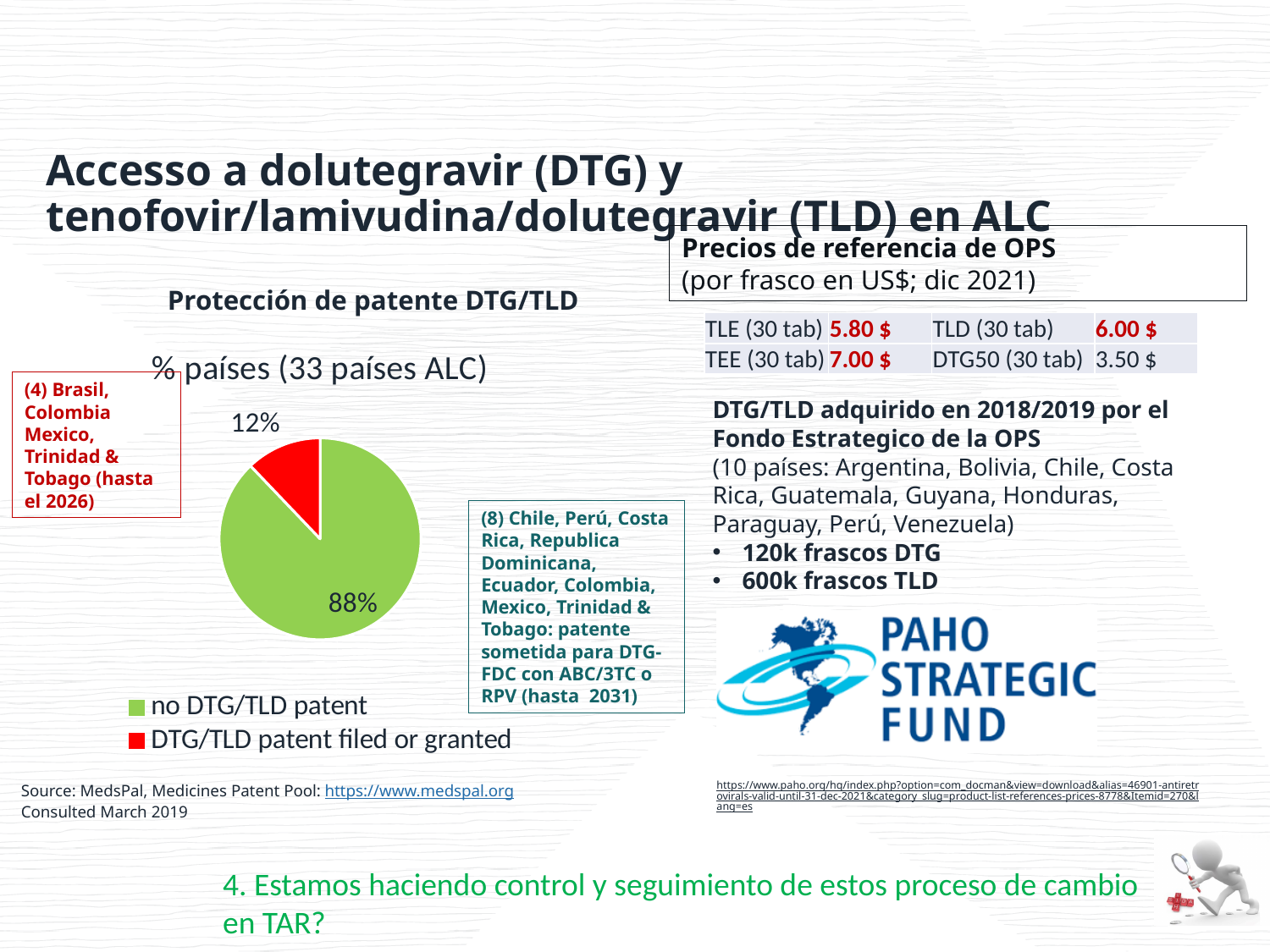
What kind of chart is shown on the slide? pie chart Which is larger: the share of countries with no DTG/TLD patent or the share with a DTG/TLD patent filed or granted? no DTG/TLD patent Which category has the largest share of the pie? no DTG/TLD patent What is the difference in percentage points between the 'no DTG/TLD patent' slice and the 'DTG/TLD patent filed or granted' slice? 76 How many slices does the pie chart have? 2 What percentage of countries have a DTG/TLD patent filed or granted? 12% What is the title of the pie chart? % países (33 países ALC) Which category has the smallest share of the pie? DTG/TLD patent filed or granted How many entries does the legend list? 2 What colour represents 'DTG/TLD patent filed or granted' in the pie chart? red What percentage of countries have no DTG/TLD patent? 88% What share of the pie does the 'no DTG/TLD patent' slice represent? 88%